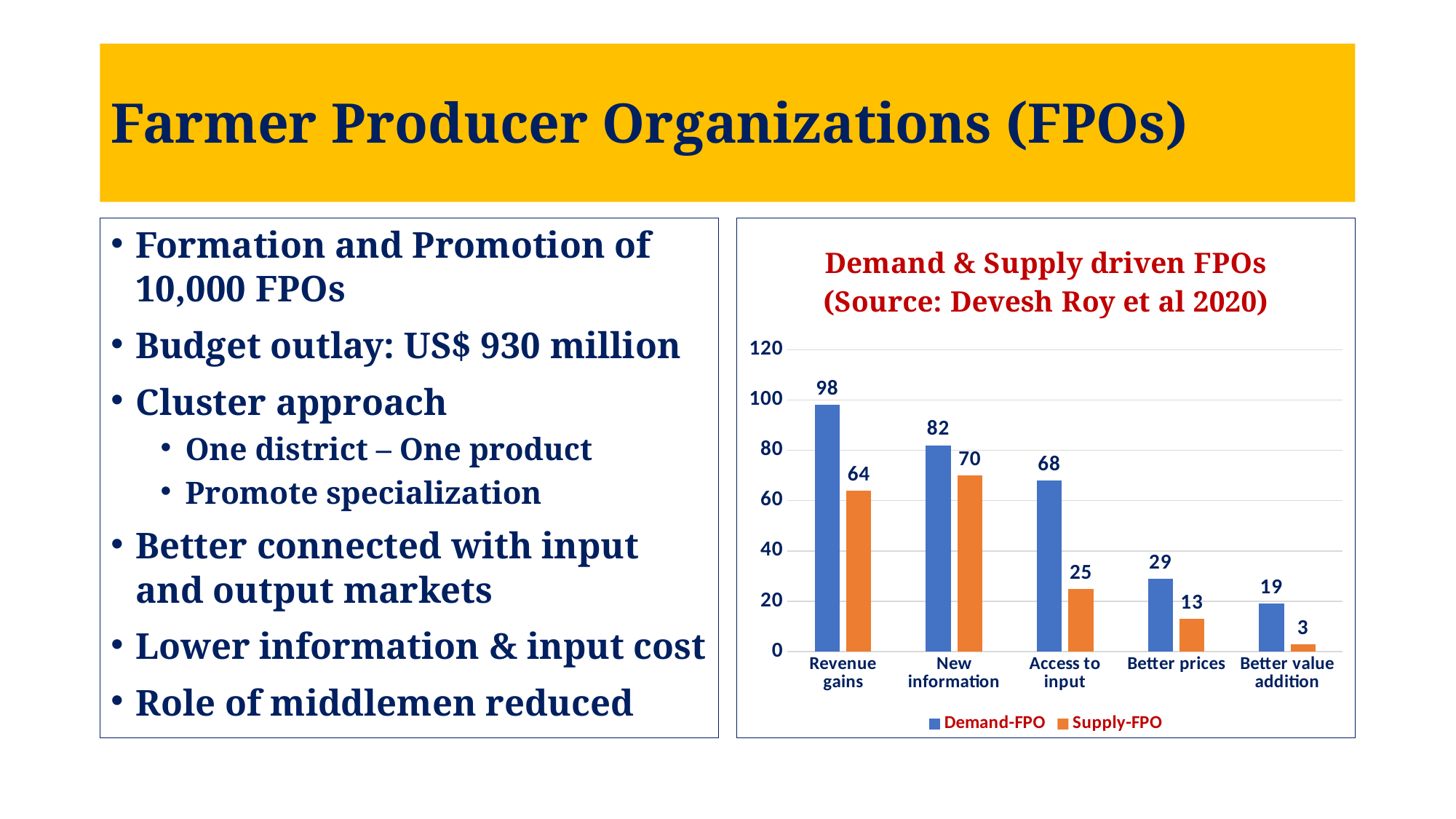
How many series does the legend list? 2 What is the Supply-FPO value for Better value addition? 3 What is the difference between the Demand-FPO and Supply-FPO values for Access to input? 43 Which category has the lowest Supply-FPO value? Better value addition How many categories are shown on the x axis? 5 What kind of chart is shown on the slide? Bar chart What is the Supply-FPO value for New information? 70 Which is larger for Better prices: the Demand-FPO value or the Supply-FPO value? Demand-FPO What is the title of the chart? Demand & Supply driven FPOs (Source: Devesh Roy et al 2020) Is the Supply-FPO value for Revenue gains greater or less than 60? greater Which category has the highest Demand-FPO value? Revenue gains What is the Demand-FPO value for Revenue gains? 98